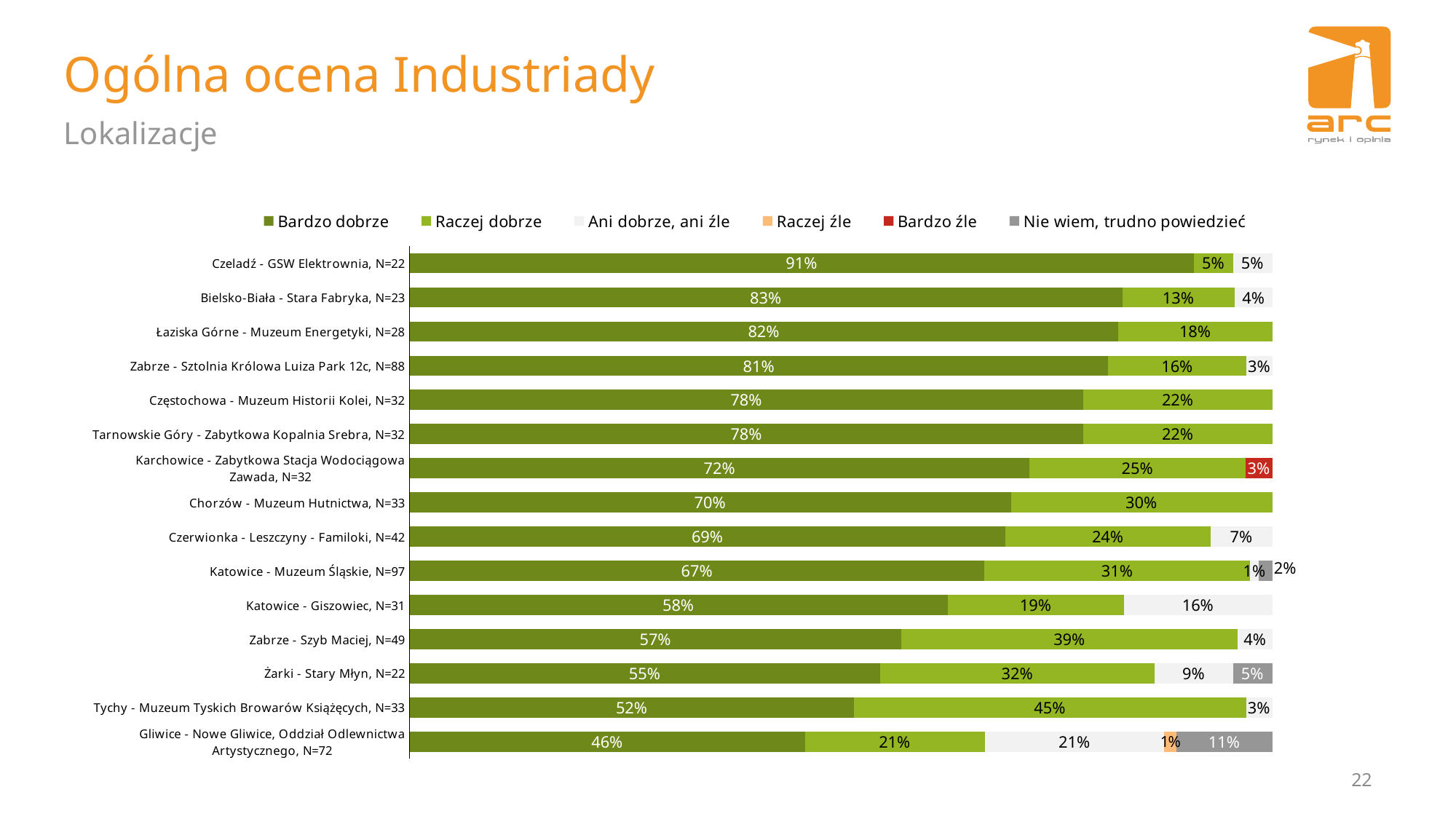
Which location is the only one with a "Bardzo źle" value shown, and what is it? Karchowice - Zabytkowa Stacja Wodociągowa Zawada, N=32; 3% What is the difference between the "Bardzo dobrze" values for Bielsko-Biała - Stara Fabryka, N=23 and Katowice - Giszowiec, N=31? 25 percentage points Which location has the highest "Bardzo dobrze" share? Czeladź - GSW Elektrownia, N=22 Which has a larger "Raczej dobrze" value: Zabrze - Szyb Maciej, N=49 or Żarki - Stary Młyn, N=22? Zabrze - Szyb Maciej, N=49 What is the "Nie wiem, trudno powiedzieć" value for Gliwice - Nowe Gliwice, Oddział Odlewnictwa Artystycznego, N=72? 11% How many locations are shown in the chart? 15 What is the combined share of "Bardzo dobrze" and "Raczej dobrze" for Chorzów - Muzeum Hutnictwa, N=33? 100% What kind of chart is shown on the slide? Stacked bar chart What percentage of respondents rated Czeladź - GSW Elektrownia, N=22 as "Bardzo dobrze"? 91% What is the "Raczej dobrze" value for Tychy - Muzeum Tyskich Browarów Książęcych, N=33? 45% Which location has the lowest "Bardzo dobrze" share? Gliwice - Nowe Gliwice, Oddział Odlewnictwa Artystycznego, N=72 How many series does the legend list? 6